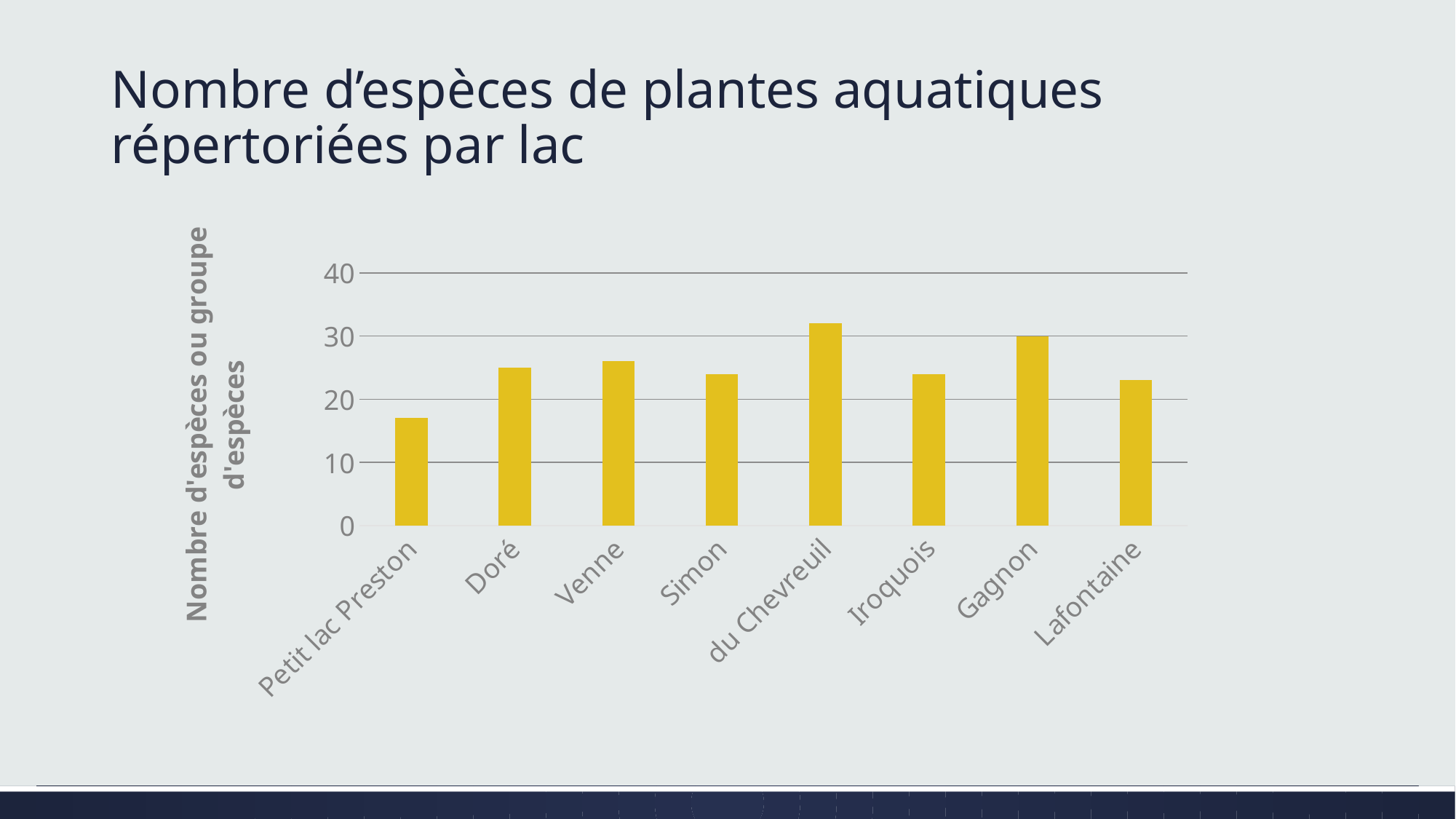
Which has a higher value, Gagnon or Lafontaine? Gagnon Is the value for Lafontaine greater or less than 20? greater What colour are the bars in the chart? yellow Which lake has the highest number of aquatic plant species? du Chevreuil Is the value for du Chevreuil greater or less than 30? greater Is the value for Petit lac Preston greater or less than 20? less Which has a higher value, Doré or Petit lac Preston? Doré What kind of chart is shown on the slide? bar chart What is the title of the vertical axis of the chart? Nombre d'espèces ou groupe d'espèces Which lake has the lowest number of aquatic plant species? Petit lac Preston How many lakes are shown on the x axis of the chart? 8